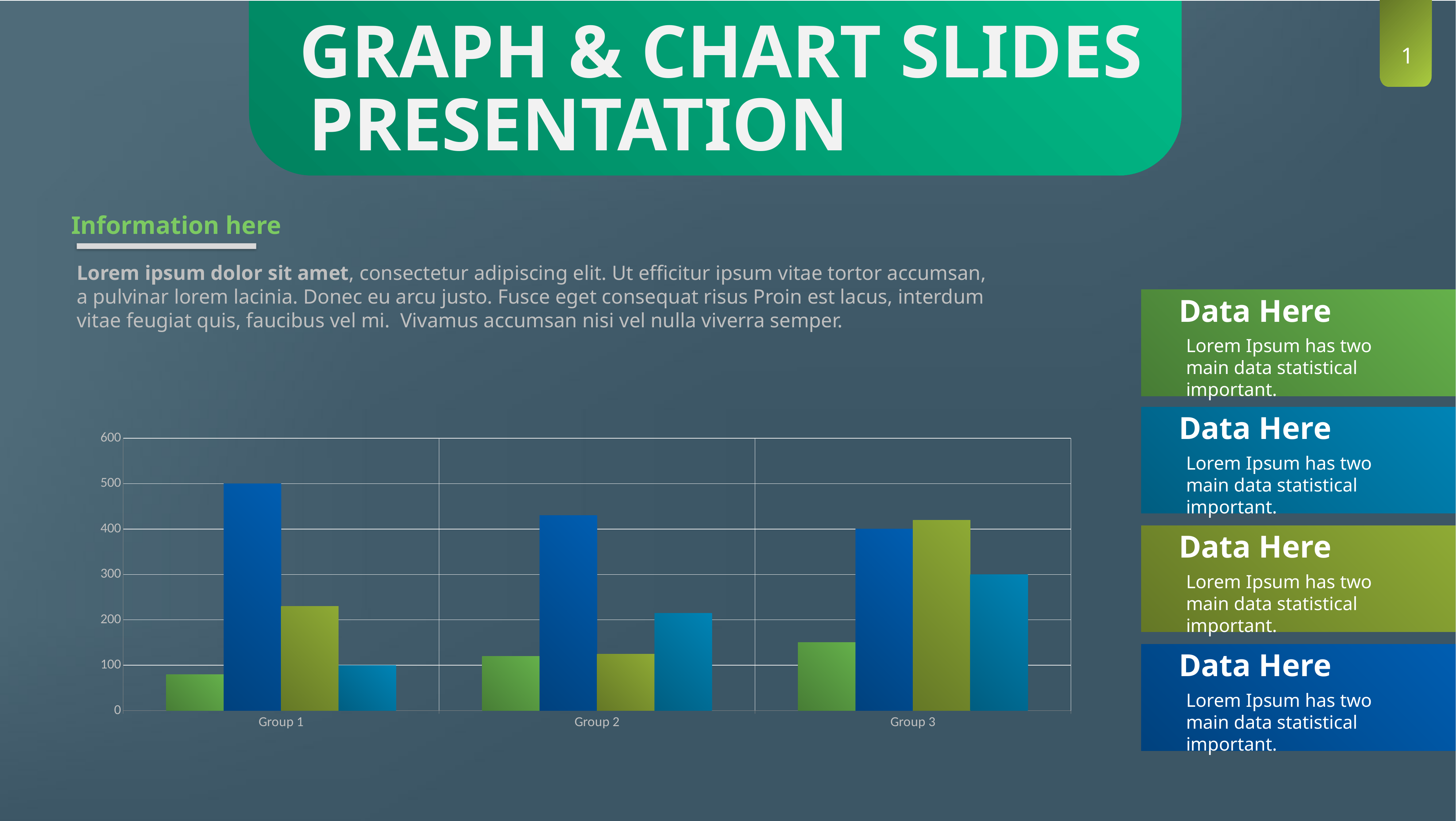
Is the value of the olive bar for Group 3 greater or less than 400? greater How many groups are shown on the x axis of the chart? 3 Is the value of the green bar for Group 1 greater or less than 100? less Which is larger in Group 2: the dark blue bar or the light blue bar? the dark blue bar What is the value of the light blue bar for Group 1? 100 What is the value of the dark blue bar for Group 3? 400 Is the value of the dark blue bar for Group 2 greater or less than 400? greater Which group has the tallest bar in the chart? Group 1 What is the value of the light blue bar for Group 3? 300 What is the value of the dark blue bar for Group 1? 500 What is the highest value shown on the vertical axis of the chart? 600 What kind of chart is shown on the slide? bar chart